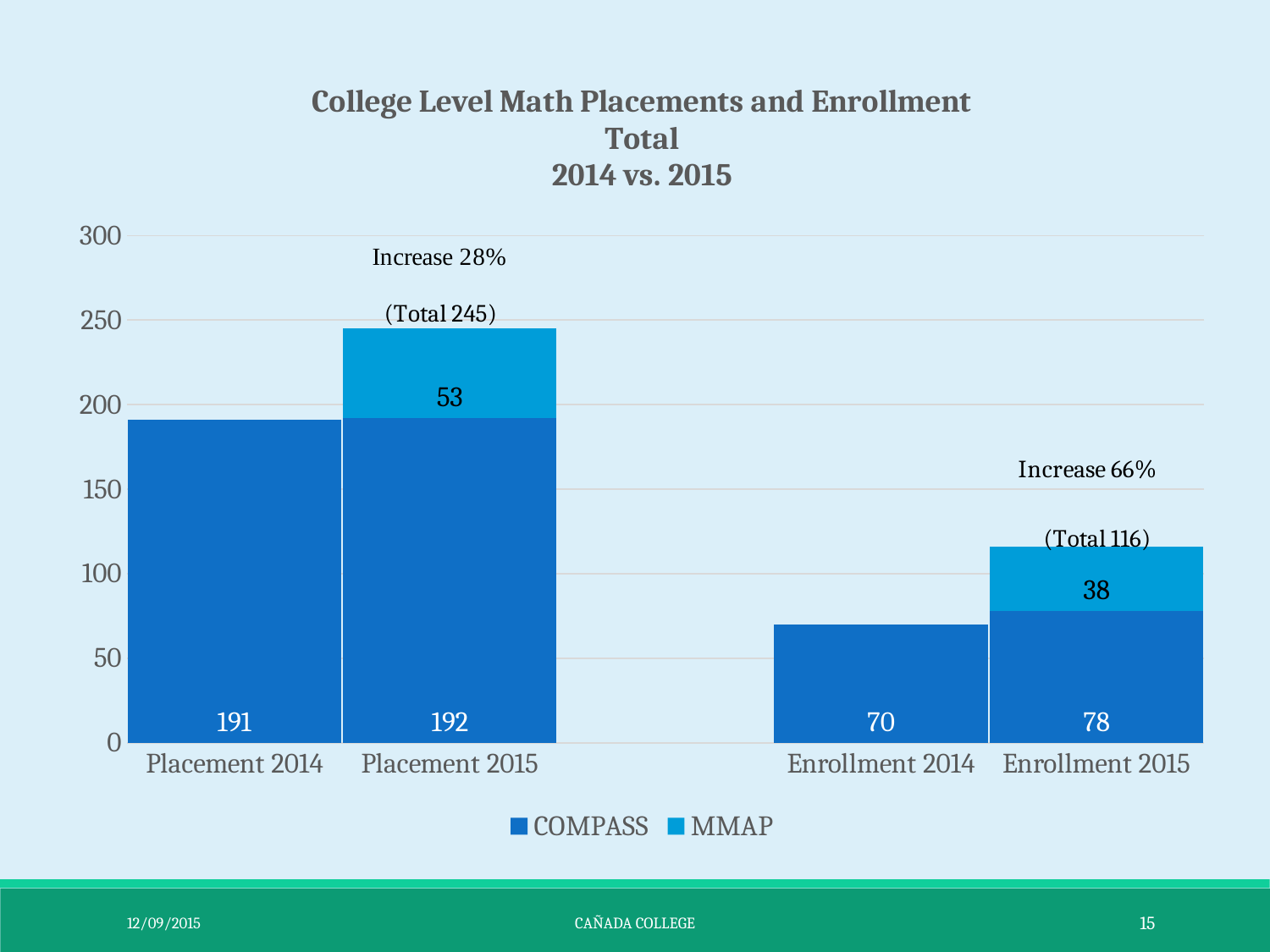
What is the total of the stacked bar for Placement 2015? 245 What is the difference between the COMPASS values for Enrollment 2015 and Enrollment 2014? 8 What is the COMPASS value for Placement 2014? 191 Which is larger, the MMAP value for Placement 2015 or the MMAP value for Enrollment 2015? Placement 2015 Which category has the lowest COMPASS value? Enrollment 2014 What percentage increase is annotated above the Enrollment 2015 bar? Increase 66% What is the total of the stacked bar for Enrollment 2015? 116 What is the MMAP value for Placement 2015? 53 What is the COMPASS value for Enrollment 2015? 78 What kind of chart is shown on the slide? Stacked bar chart How many series does the legend list? 2 What is the MMAP value for Enrollment 2015? 38